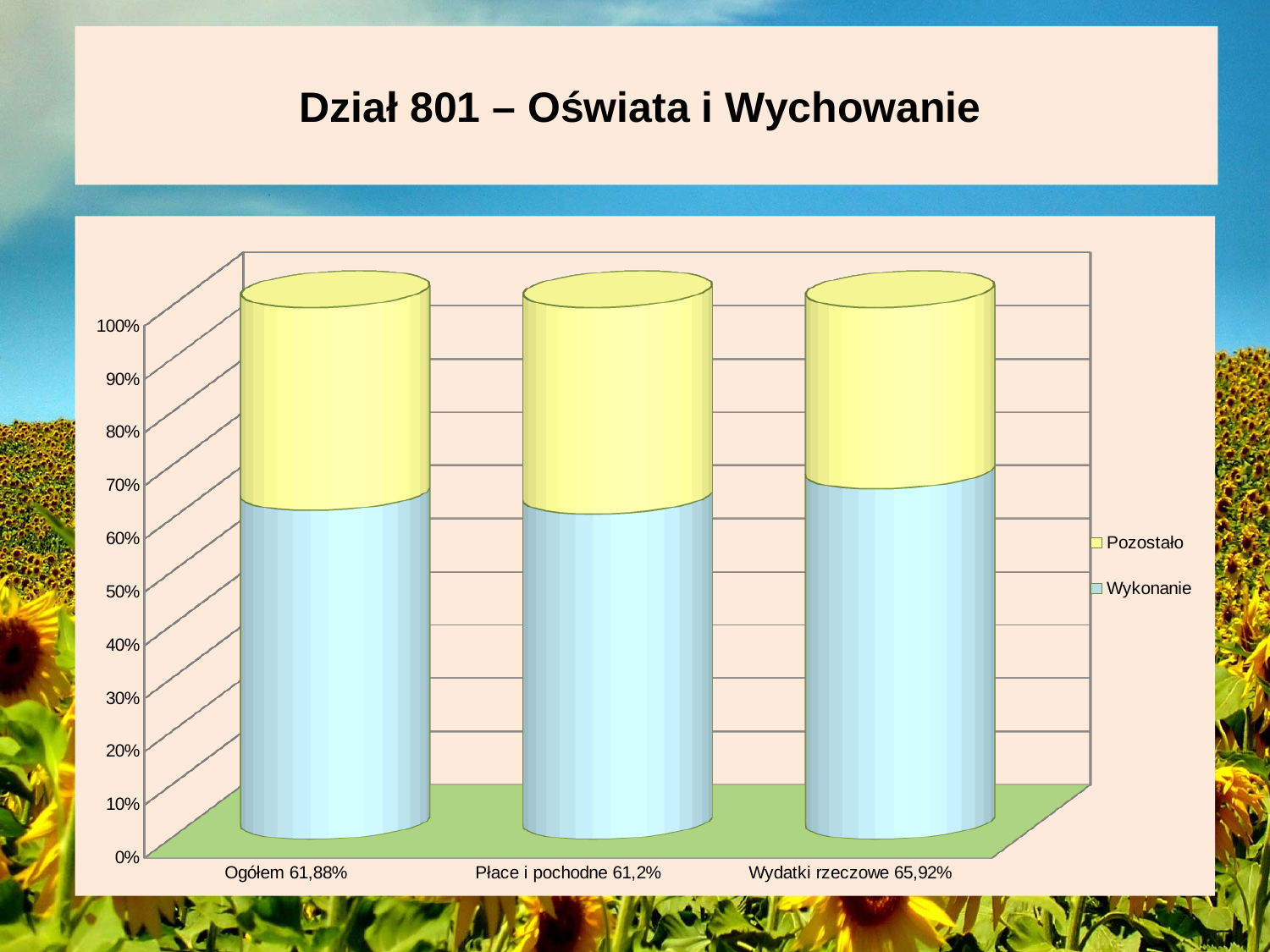
Which category has the lowest Wykonanie value? Płace i pochodne What is the title of the slide? Dział 801 – Oświata i Wychowanie What kind of chart is shown on the slide? Stacked bar chart Which category has the highest Wykonanie value? Wydatki rzeczowe What is the Wykonanie value shown for Płace i pochodne? 61,2% Which has a larger Wykonanie value, Ogółem or Płace i pochodne? Ogółem How many categories are shown on the x axis? 3 Is the Wykonanie value for Wydatki rzeczowe greater or less than 60%? greater How many series does the legend list? 2 What is the Wykonanie value shown for Wydatki rzeczowe? 65,92% What is the Wykonanie value shown for Ogółem? 61,88% What is the difference between the Wykonanie values for Wydatki rzeczowe and Płace i pochodne? 4,72%